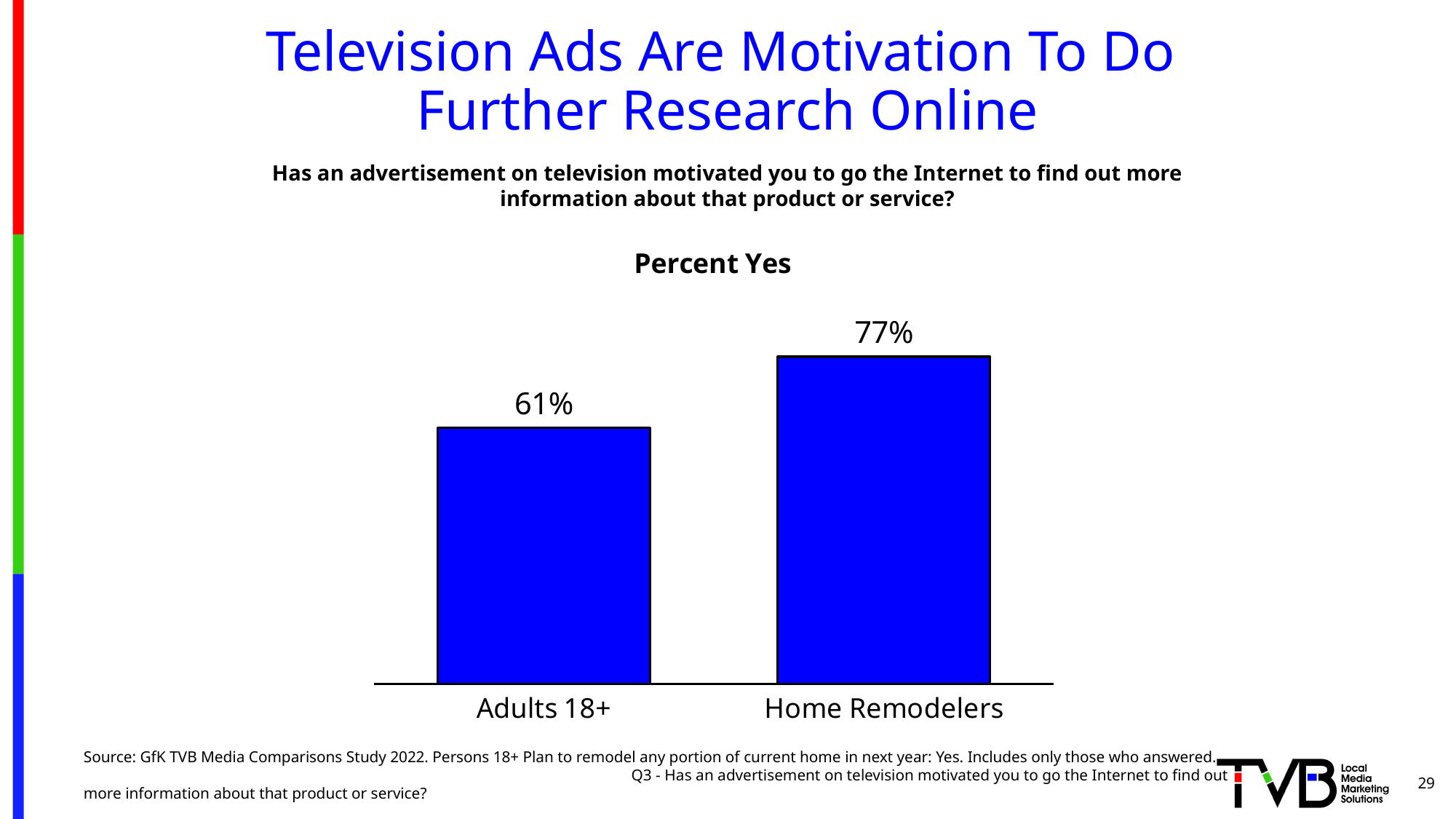
What is the Percent Yes value for Adults 18+? 61% What is the difference in Percent Yes between Home Remodelers and Adults 18+? 16 percentage points What is the Percent Yes value for Home Remodelers? 77% Which is larger, the value for Adults 18+ or the value for Home Remodelers? Home Remodelers How many categories are shown in the chart? 2 What is the title of the chart? Percent Yes Which category has the highest Percent Yes value? Home Remodelers Which category has the lowest Percent Yes value? Adults 18+ What colour are the bars in the chart? Blue What kind of chart is shown on the slide? Bar chart